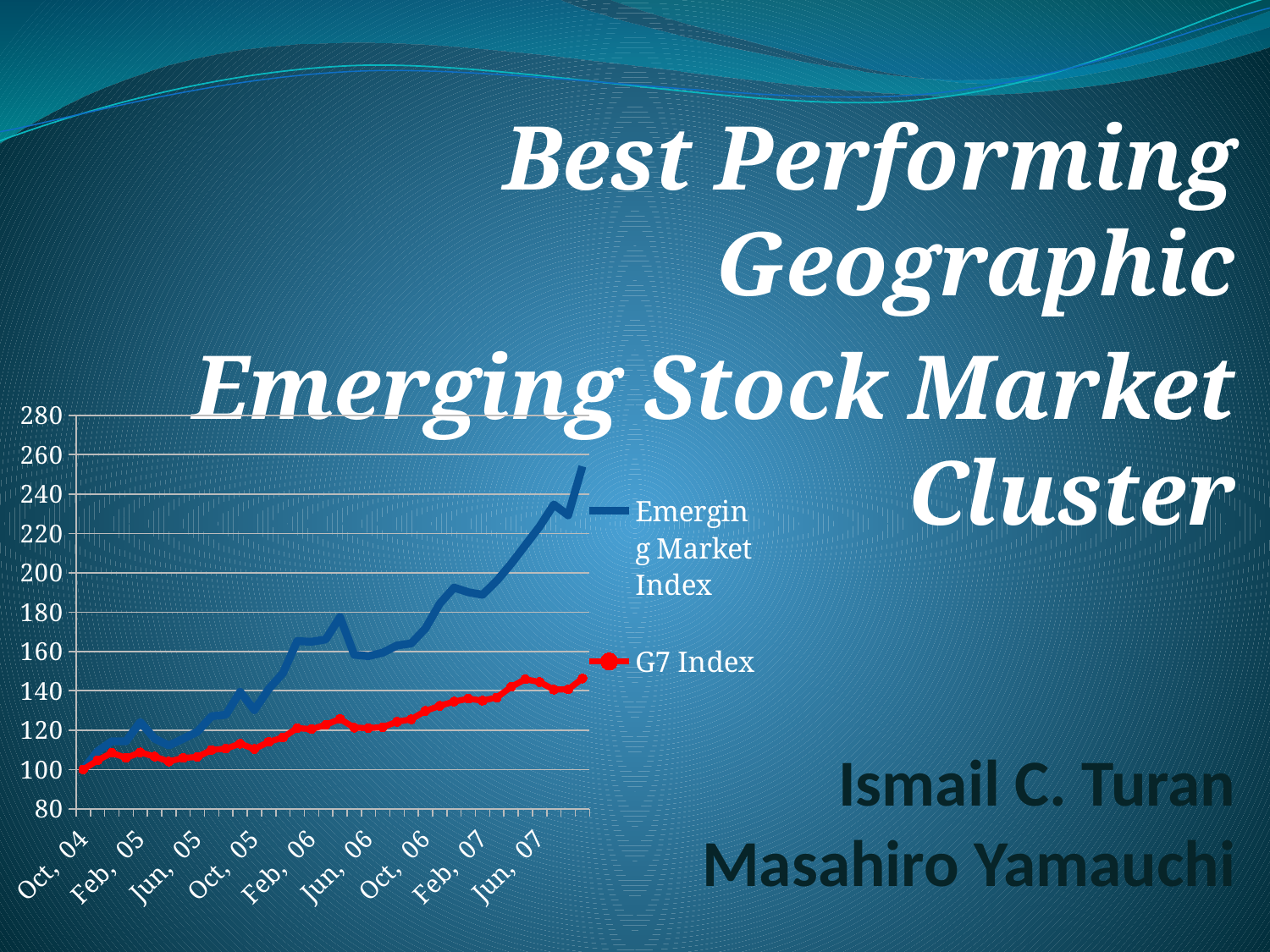
Does the Emerging Market Index rise or fall overall from Oct, 04 to Jun, 07? rise Which colour is used for the G7 Index line? red Does the G7 Index rise or fall overall from Oct, 04 to Jun, 07? rise What kind of chart is shown on the slide? line chart Is the value of the Emerging Market Index at Oct, 04 greater or less than 120? less Is the value of the G7 Index at Jun, 07 greater or less than 160? less Which series reaches the highest value on the chart? Emerging Market Index How many series does the chart's legend list? 2 At Jun, 07, which series has the larger value, Emerging Market Index or G7 Index? Emerging Market Index What is the value of the G7 Index at Oct, 04? 100 What are the two series named in the chart's legend? Emerging Market Index and G7 Index Is the value of the Emerging Market Index at Jun, 07 greater or less than 200? greater